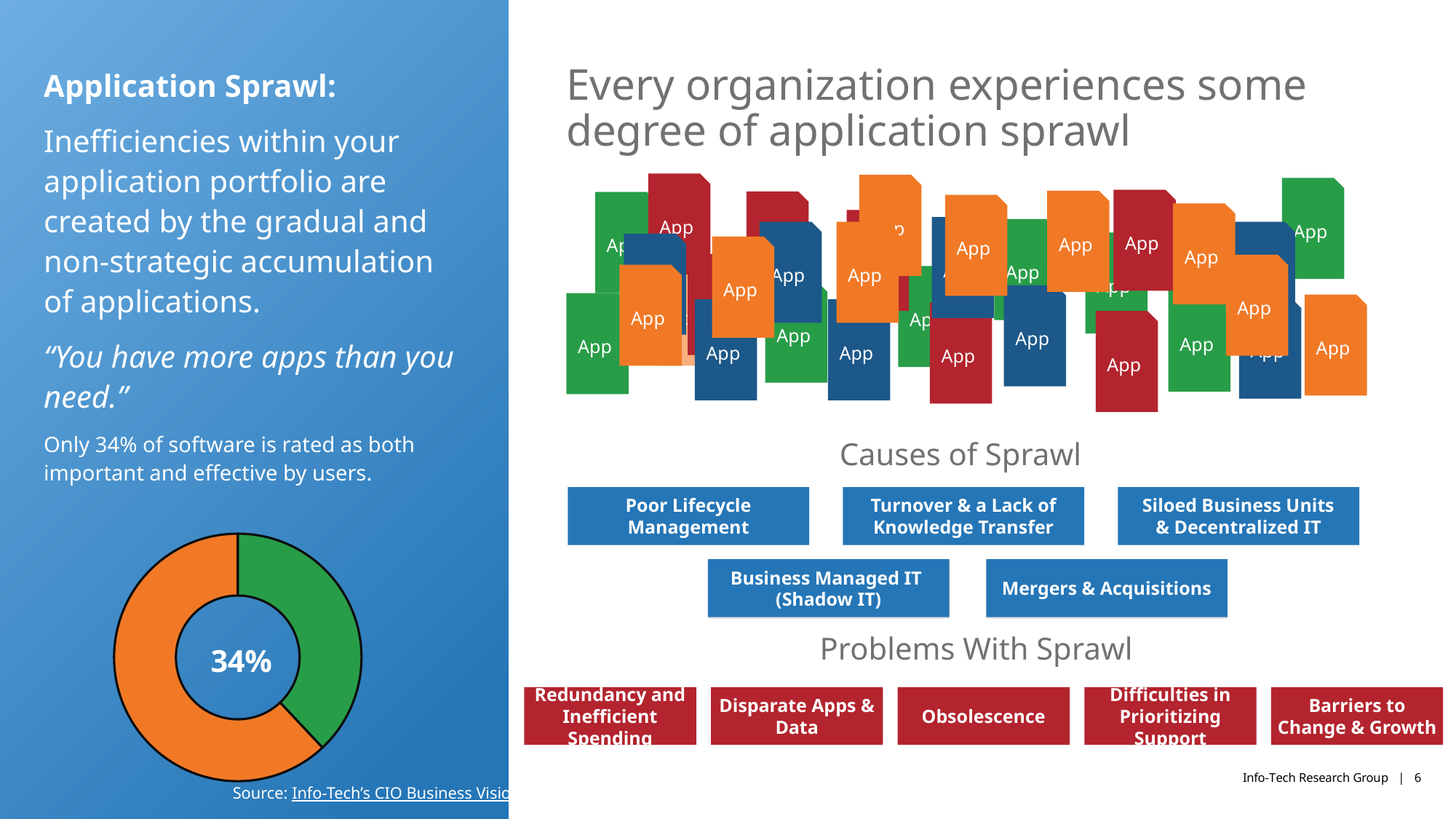
Which slice of the donut chart is larger, the orange one or the green one? Orange How many slices does the donut chart have? 2 What percentage is printed in the centre of the donut chart? 34% Which colour is used for the smaller slice of the donut chart? Green What kind of chart is shown on the left side of the slide? Pie chart (donut) According to the slide text, what does the 34% in the donut chart represent? Software rated as both important and effective by users